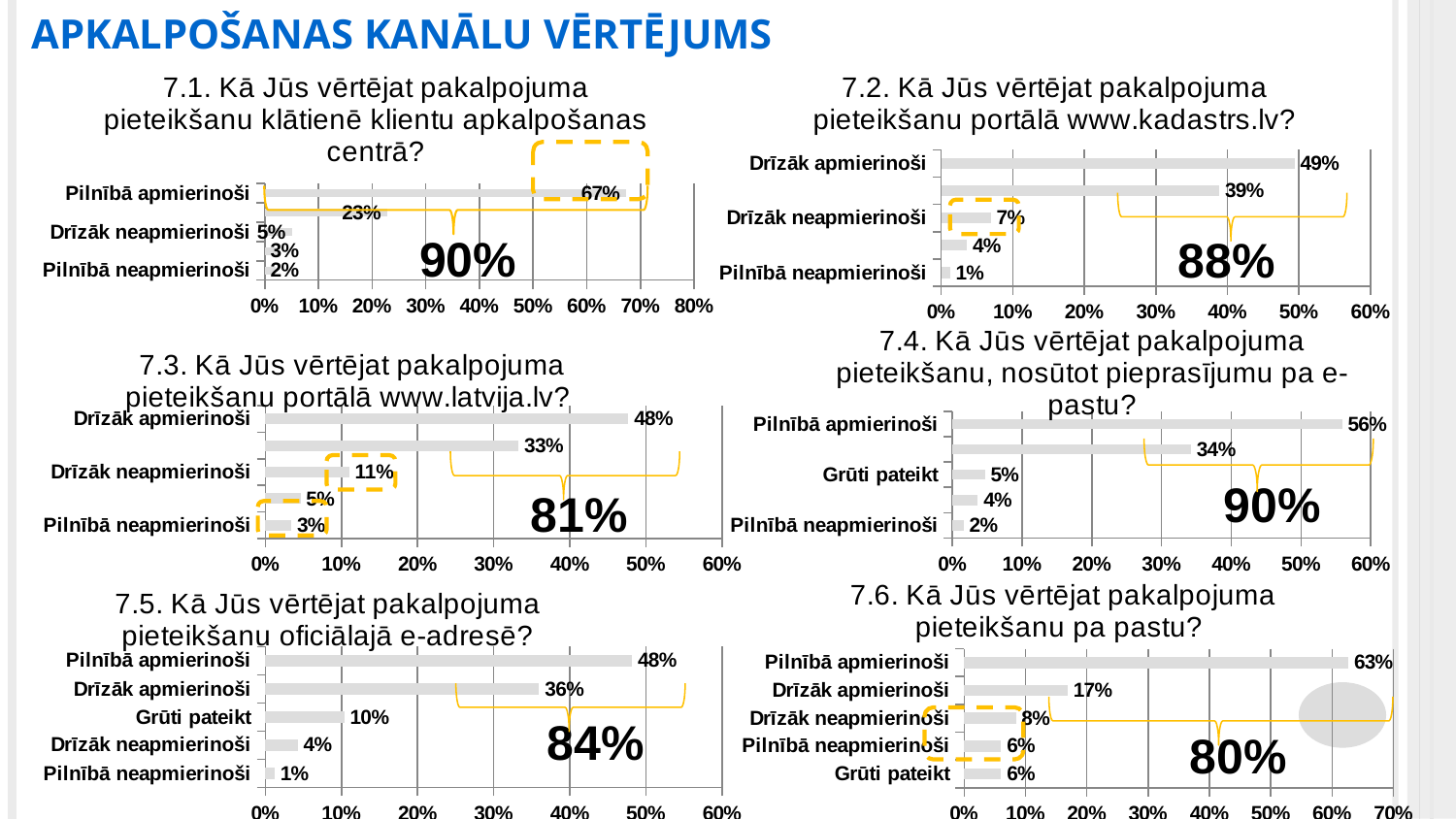
In the chart 7.5 (pieteikšanu oficiālajā e-adresē), what is the value for Pilnībā apmierinoši? 48% In the chart 7.1 (klātienē klientu apkalpošanas centrā), which category has the highest value? Pilnībā apmierinoši In the chart 7.5 (pieteikšanu oficiālajā e-adresē), which category has the lowest value? Pilnībā neapmierinoši In the chart 7.3 (portālā www.latvija.lv), what is the difference between Drīzāk apmierinoši and Drīzāk neapmierinoši? 37% How many charts are shown on the slide? 6 In the chart 7.5 (pieteikšanu oficiālajā e-adresē), which is larger: Grūti pateikt or Drīzāk neapmierinoši? Grūti pateikt In the chart 7.6 (pieteikšanu pa pastu), what is the difference between Pilnībā apmierinoši and Drīzāk apmierinoši? 46% What type of chart is used for 7.2 (portālā www.kadastrs.lv)? Bar chart In the chart 7.2 (portālā www.kadastrs.lv), what is the value for Drīzāk neapmierinoši? 7% In the chart 7.6 (pieteikšanu pa pastu), what is the value for Drīzāk apmierinoši? 17% In the chart 7.4 (nosūtot pieprasījumu pa e-pastu), what is the value for Grūti pateikt? 5% How many bars does the chart 7.6 (pieteikšanu pa pastu) show? 5